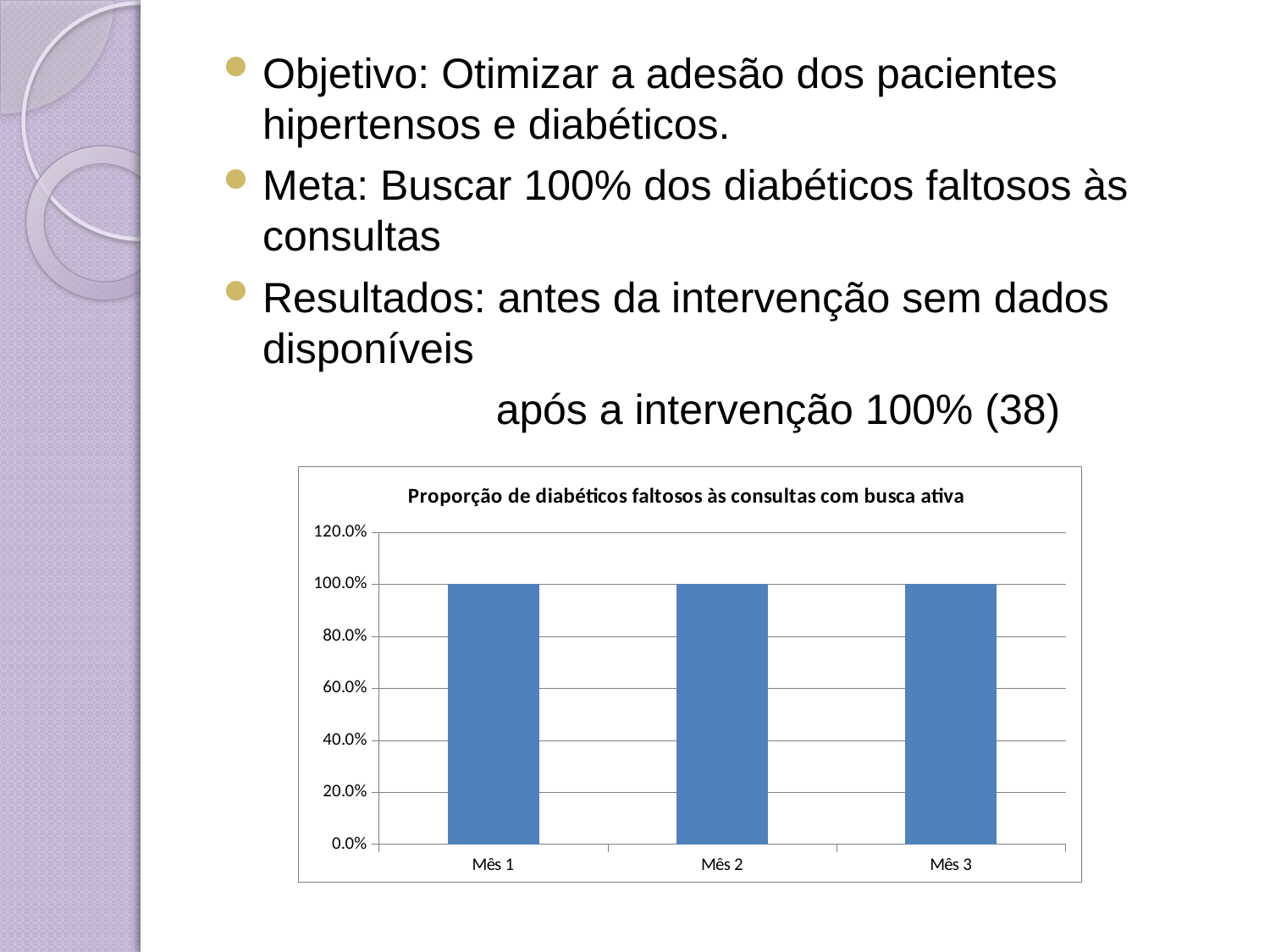
What is the value for Mês 1 in the chart? 100.0% What is the value for Mês 2 in the chart? 100.0% Do the values rise, fall, or stay flat from Mês 1 to Mês 3? stay flat What is the difference between the values for Mês 1 and Mês 3? 0.0% What is the value for Mês 3 in the chart? 100.0% What is the highest value shown on the chart's y axis? 120.0% How many categories are shown on the x axis of the chart? 3 Is the value for Mês 3 greater or less than 120.0%? less What is the title of the chart? Proporção de diabéticos faltosos às consultas com busca ativa What type of chart is shown on the slide? bar chart Is the value for Mês 2 greater or less than 80.0%? greater